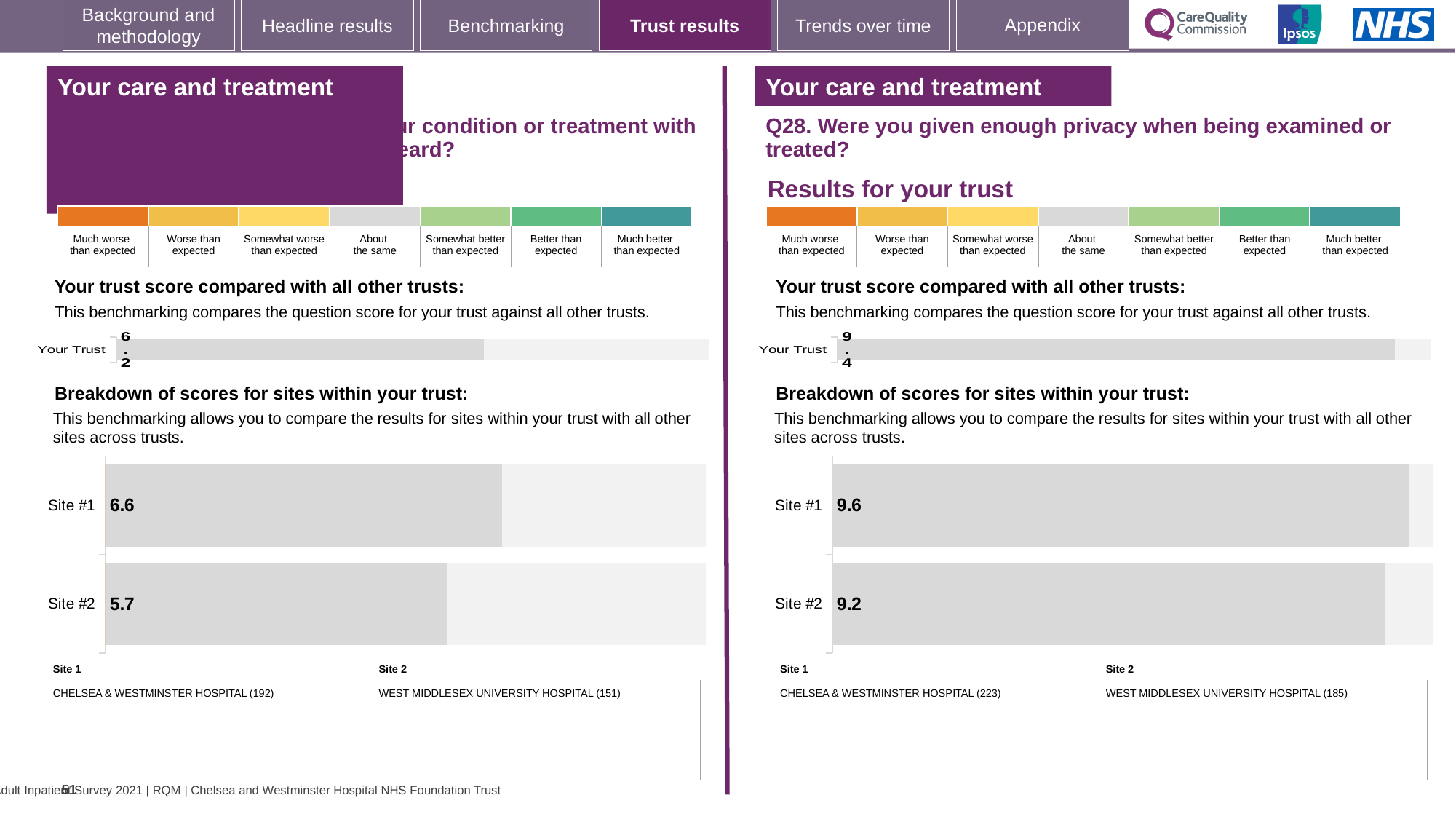
On the right-hand chart for Q28, what is the score for Site #2? 9.2 How many sites are shown in the site breakdown chart on the right-hand side for Q28? 2 On the left-hand site breakdown chart, which site has the lower score? Site #2 On the right-hand chart for Q28, which site has the higher score? Site #1 On the left-hand site breakdown chart, what is the difference between the Site #1 and Site #2 scores? 0.9 On the right-hand chart for Q28 (privacy when being examined or treated), what is the score for Site #1? 9.6 On the left-hand site breakdown chart, what is the score for Site #2? 5.7 On the right-hand chart for Q28, what is the 'Your Trust' score compared with all other trusts? 9.4 On the right-hand chart for Q28, what is the difference between the Site #1 and Site #2 scores? 0.4 On the left-hand chart, what is the 'Your Trust' score compared with all other trusts? 6.2 What type of chart is used for the breakdown of scores for sites within your trust? Bar chart On the left-hand site breakdown chart, what is the score for Site #1? 6.6